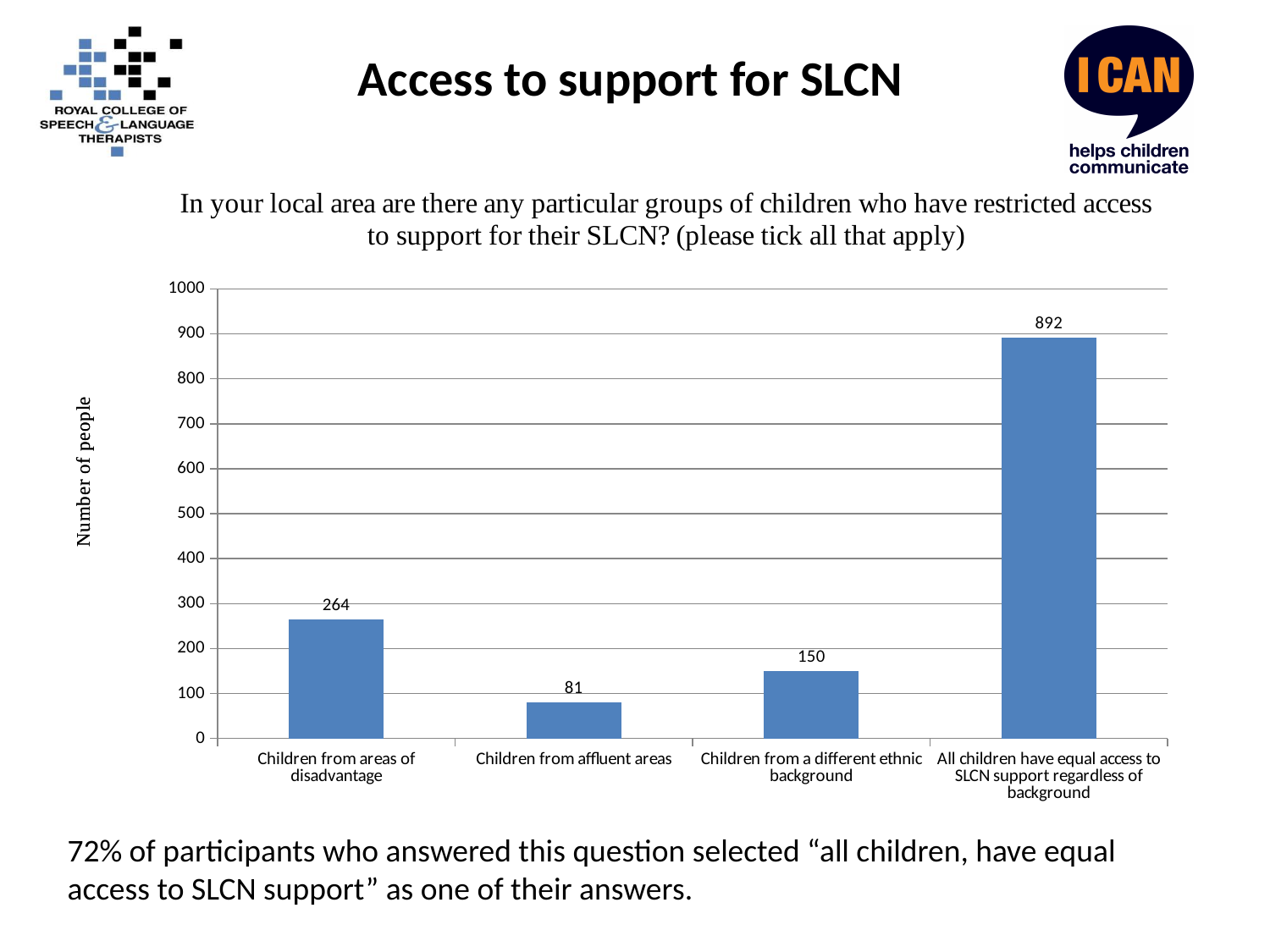
What is the value for "Children from a different ethnic background"? 150 What is the value for "Children from affluent areas"? 81 What is the difference between the values for "Children from areas of disadvantage" and "Children from a different ethnic background"? 114 What kind of chart is shown on the slide? Bar chart What is the value for "All children have equal access to SLCN support regardless of background"? 892 What is the label of the vertical axis? Number of people How many categories are shown on the chart? 4 Which category has the highest value? All children have equal access to SLCN support regardless of background Which category has the lowest value? Children from affluent areas Which is larger, the value for "Children from a different ethnic background" or "Children from affluent areas"? Children from a different ethnic background What is the difference between the values for "All children have equal access to SLCN support regardless of background" and "Children from areas of disadvantage"? 628 What is the value for "Children from areas of disadvantage"? 264